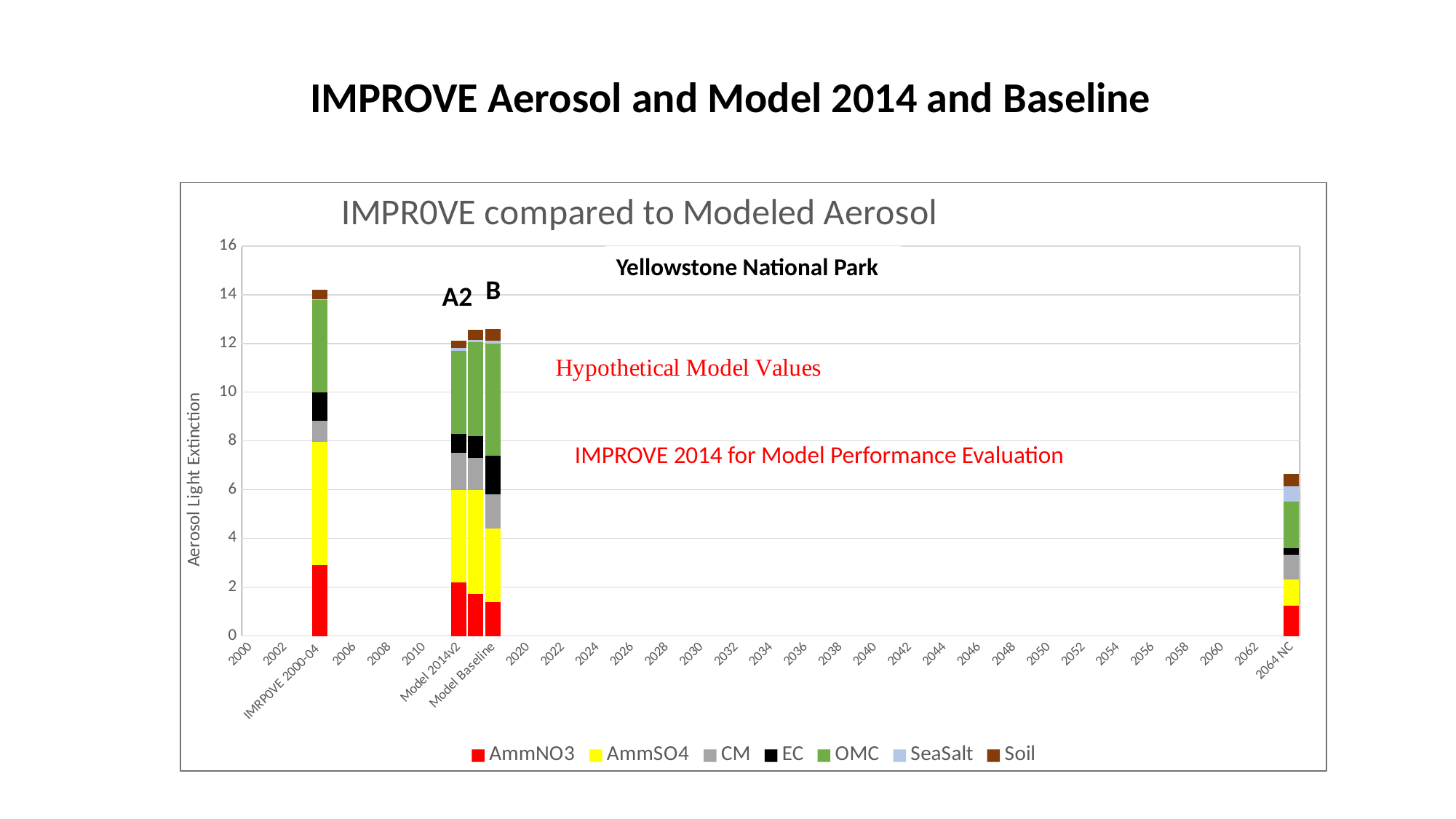
Which bar has the highest total aerosol light extinction? IMRPOVE 2000-04 How many stacked bars are plotted on the chart? 5 Which has a larger total, IMRPOVE 2000-04 or 2064 NC? IMRPOVE 2000-04 Is the AmmSO4 segment of the IMRPOVE 2000-04 bar greater or less than 4? greater What kind of chart is shown on the slide? stacked bar chart Is the total value for 2064 NC greater or less than 8? less Is the total value for Model 2014v2 greater or less than 10? greater What is the label of the vertical axis? Aerosol Light Extinction What is the title of the chart? IMPR0VE compared to Modeled Aerosol Which bar has the lowest total aerosol light extinction? 2064 NC How many series does the legend list? 7